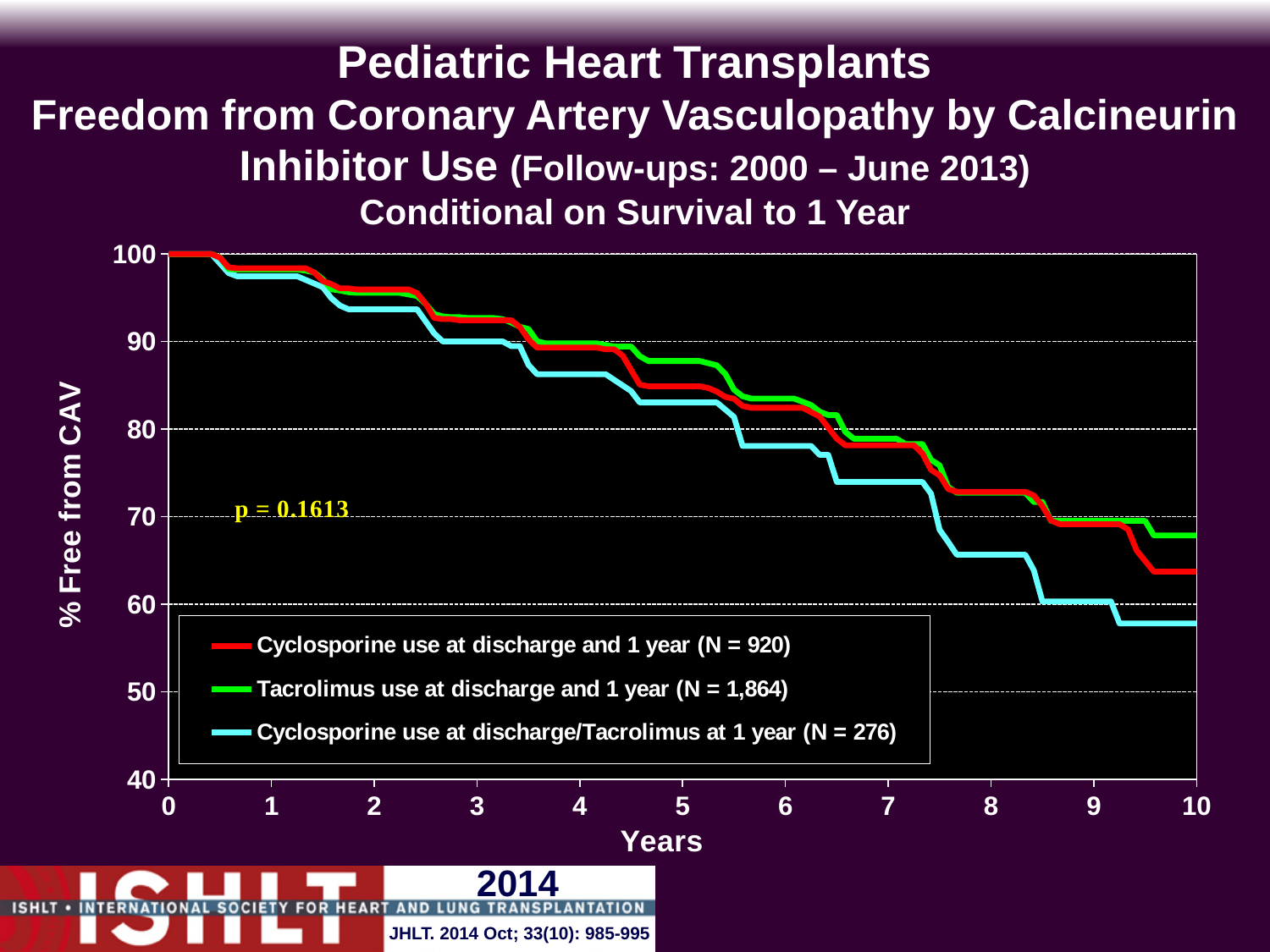
What kind of chart is shown on the slide? line chart Is the value for the Cyclosporine use at discharge and 1 year series at year 5 greater or less than 80? greater Do the values for the Cyclosporine use at discharge and 1 year series rise or fall as years increase? fall Is the value for the Cyclosporine use at discharge/Tacrolimus at 1 year series at year 8 greater or less than 70? less Is the value for the Cyclosporine use at discharge/Tacrolimus at 1 year series at year 10 greater or less than 60? less How many series does the legend list? 3 What is the N given in the legend for the Tacrolimus use at discharge and 1 year series? 1,864 What p-value is printed on the chart? p = 0.1613 At year 6, which is higher: the Tacrolimus use at discharge and 1 year series or the Cyclosporine use at discharge/Tacrolimus at 1 year series? Tacrolimus use at discharge and 1 year At year 10, which series has the lowest % free from CAV? Cyclosporine use at discharge/Tacrolimus at 1 year